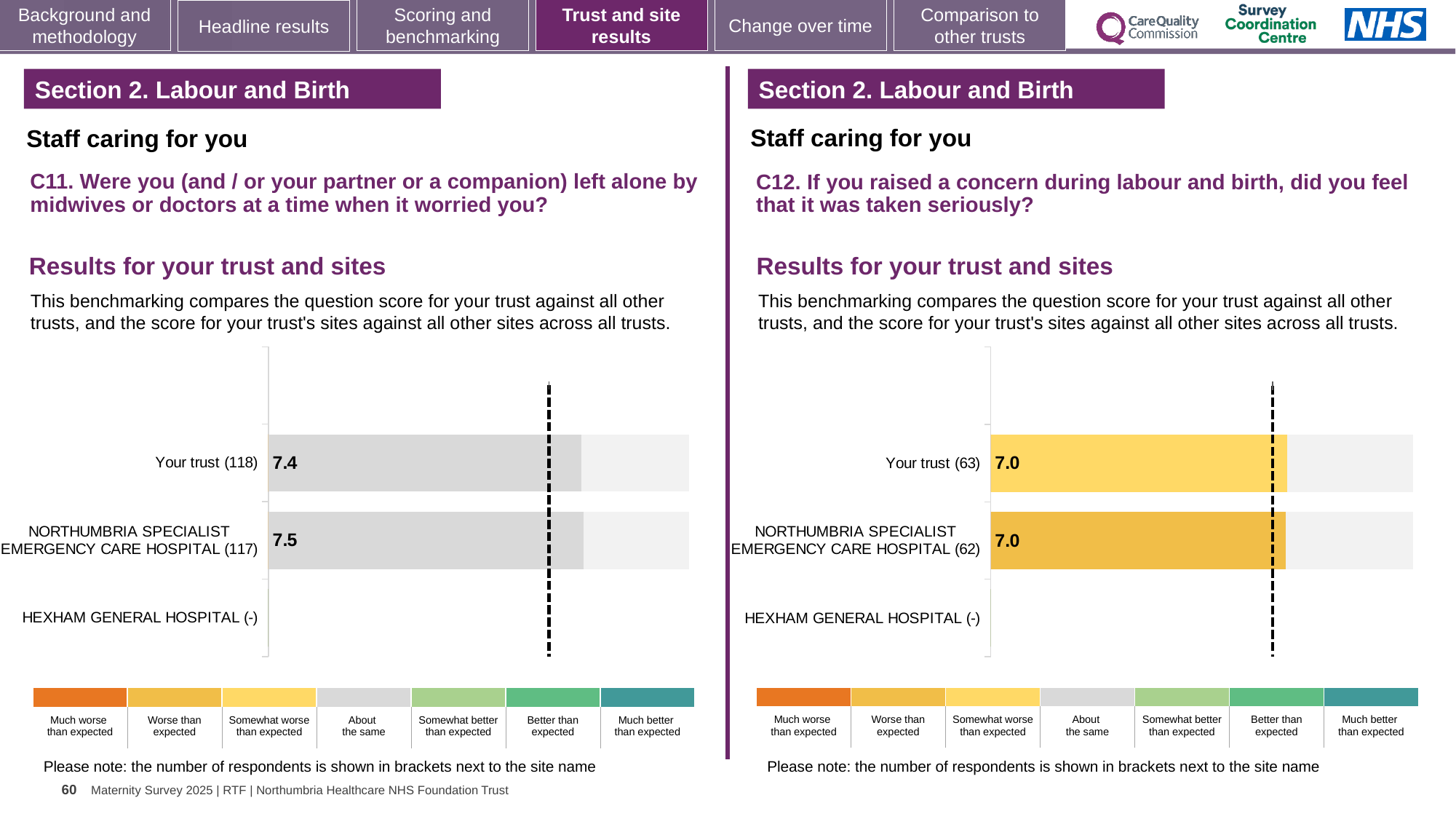
In the C12 chart on the right, what is the score for Your trust? 7.0 How many site/trust categories are listed on the y axis of the C12 chart on the right? 3 In the C11 chart on the left, what is the score for Your trust? 7.4 In the C11 chart on the left, which has the higher score: Your trust or Northumbria Specialist Emergency Care Hospital? Northumbria Specialist Emergency Care Hospital What kind of chart is used in the C11 chart on the left? Bar chart In the C11 chart on the left, what is the difference between the score for Northumbria Specialist Emergency Care Hospital and the score for Your trust? 0.1 In the C12 chart on the right, how many respondents are shown in brackets for Northumbria Specialist Emergency Care Hospital? 62 In the C11 chart on the left, what is the score for Northumbria Specialist Emergency Care Hospital? 7.5 In the C12 chart on the right, what is the score for Northumbria Specialist Emergency Care Hospital? 7.0 In the C11 chart on the left, which benchmark category does the grey colour of the Your trust bar correspond to in the legend? About the same In the C12 chart on the right, which benchmark category does the colour of the Northumbria Specialist Emergency Care Hospital bar correspond to in the legend? Worse than expected In the C11 chart on the left, how many respondents are shown in brackets for Your trust? 118